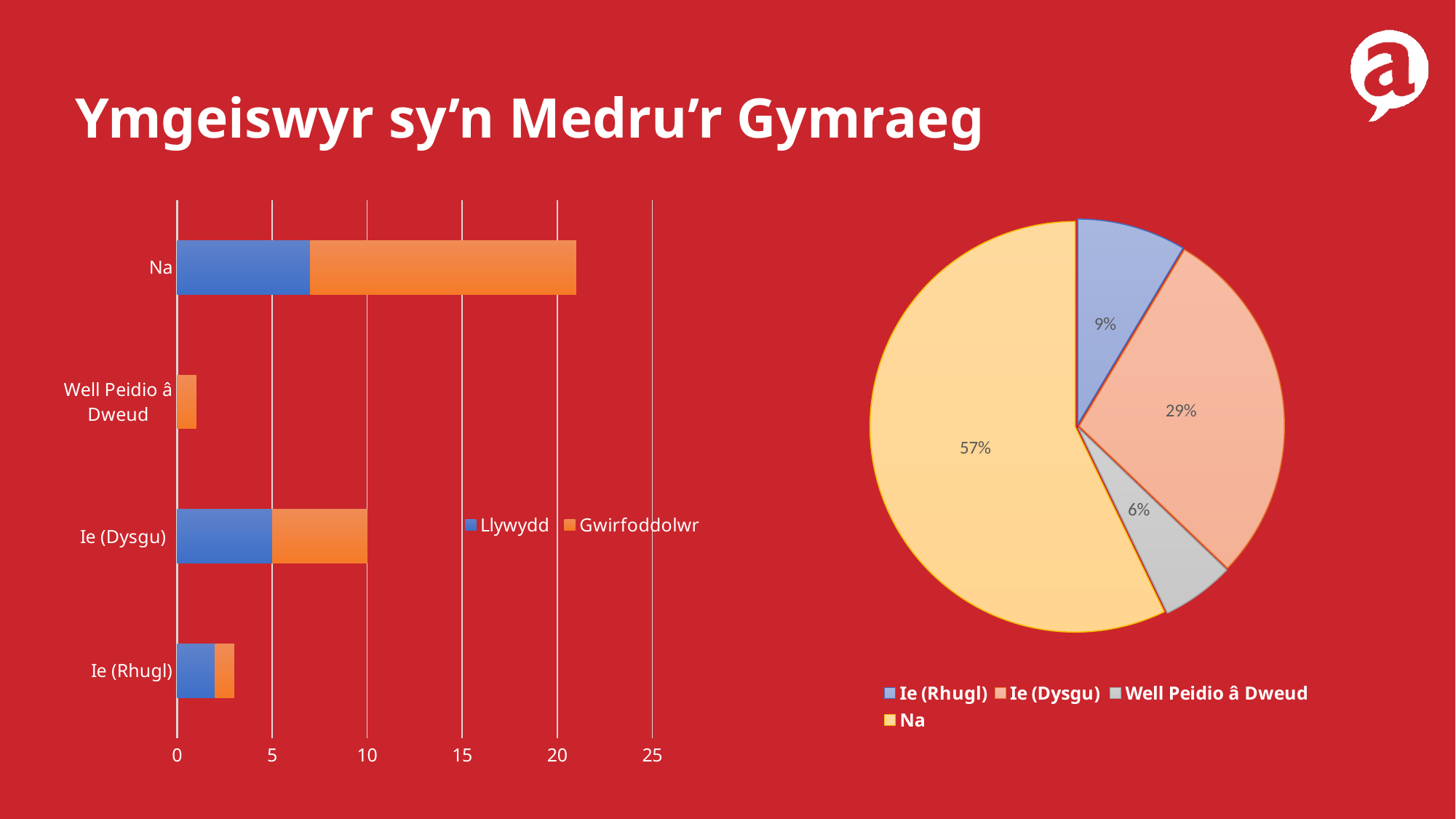
In the pie chart on the right, which category has the smallest slice? Well Peidio â Dweud In the bar chart on the left, is the total value for Na greater or less than 20? greater In the pie chart on the right, what percentage is shown for Ie (Rhugl)? 9% In the bar chart on the left, how many series does the legend list? 2 In the pie chart on the right, what is the difference in percentage points between Na and Ie (Dysgu)? 28 What kind of chart is on the left of the slide? Bar chart In the pie chart on the right, how many slices are there? 4 In the pie chart on the right, what percentage is shown for Na? 57% In the bar chart on the left, what is the total of the stacked bar for Ie (Dysgu)? 10 In the pie chart on the right, what percentage is shown for Ie (Dysgu)? 29% In the bar chart on the left, which category has the longest total bar, Na or Ie (Rhugl)? Na In the pie chart on the right, which category has the largest slice? Na